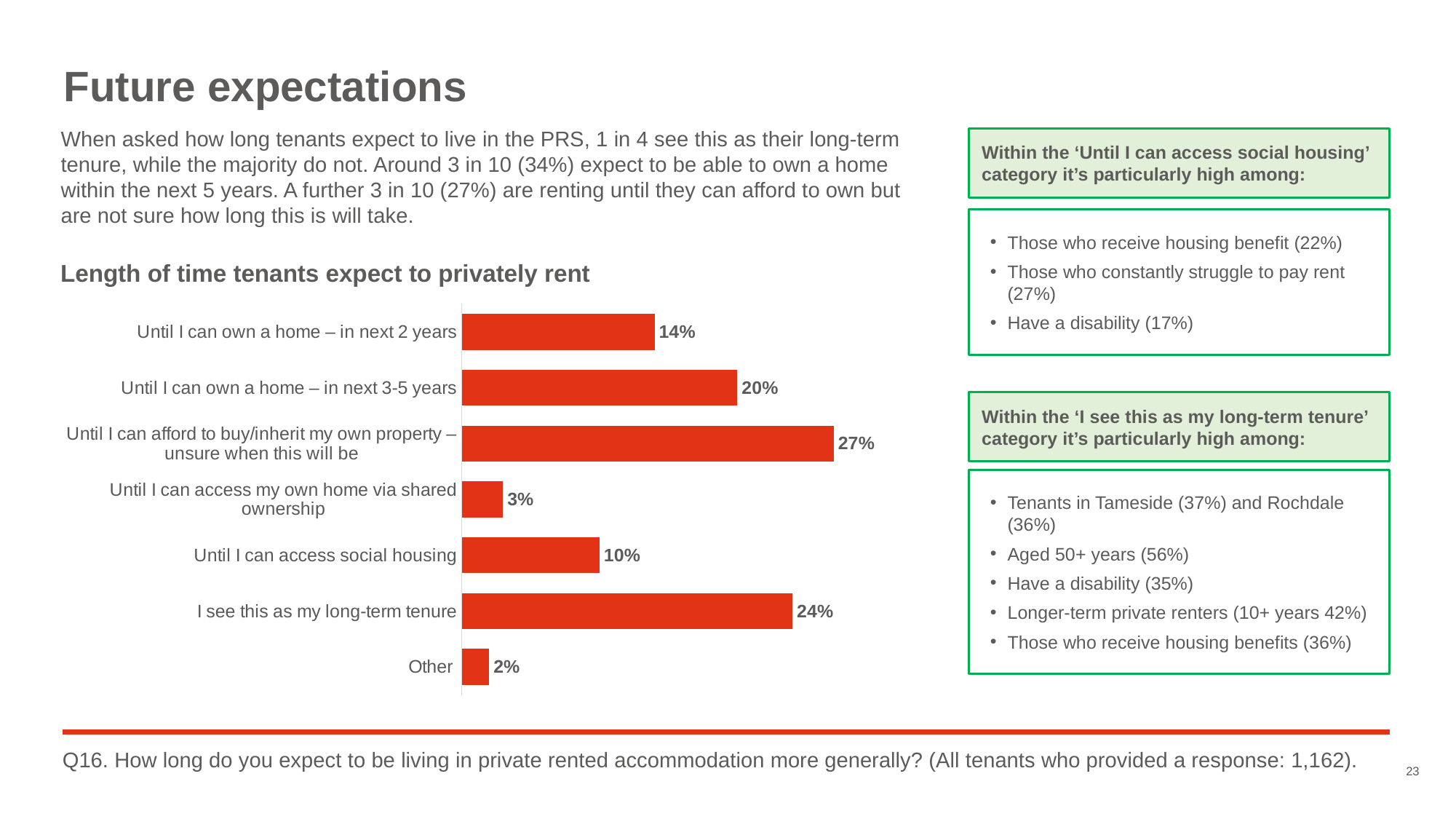
What is the title of the chart? Length of time tenants expect to privately rent What percentage of tenants expect to privately rent until they can own a home in the next 2 years? 14% What is the value for 'Until I can access my own home via shared ownership'? 3% Which category has the lowest value in the chart? Other How many categories are shown in the chart? 7 What is the value for 'Until I can access social housing'? 10% What is the combined value of the two 'Until I can own a home' categories? 34% Which category has the highest value in the chart? Until I can afford to buy/inherit my own property – unsure when this will be What percentage of tenants see this as their long-term tenure? 24% What is the difference between 'Until I can own a home – in next 3-5 years' and 'Until I can own a home – in next 2 years'? 6% What kind of chart is shown on the slide? Bar chart Which is larger: 'I see this as my long-term tenure' or 'Until I can own a home – in next 3-5 years'? I see this as my long-term tenure